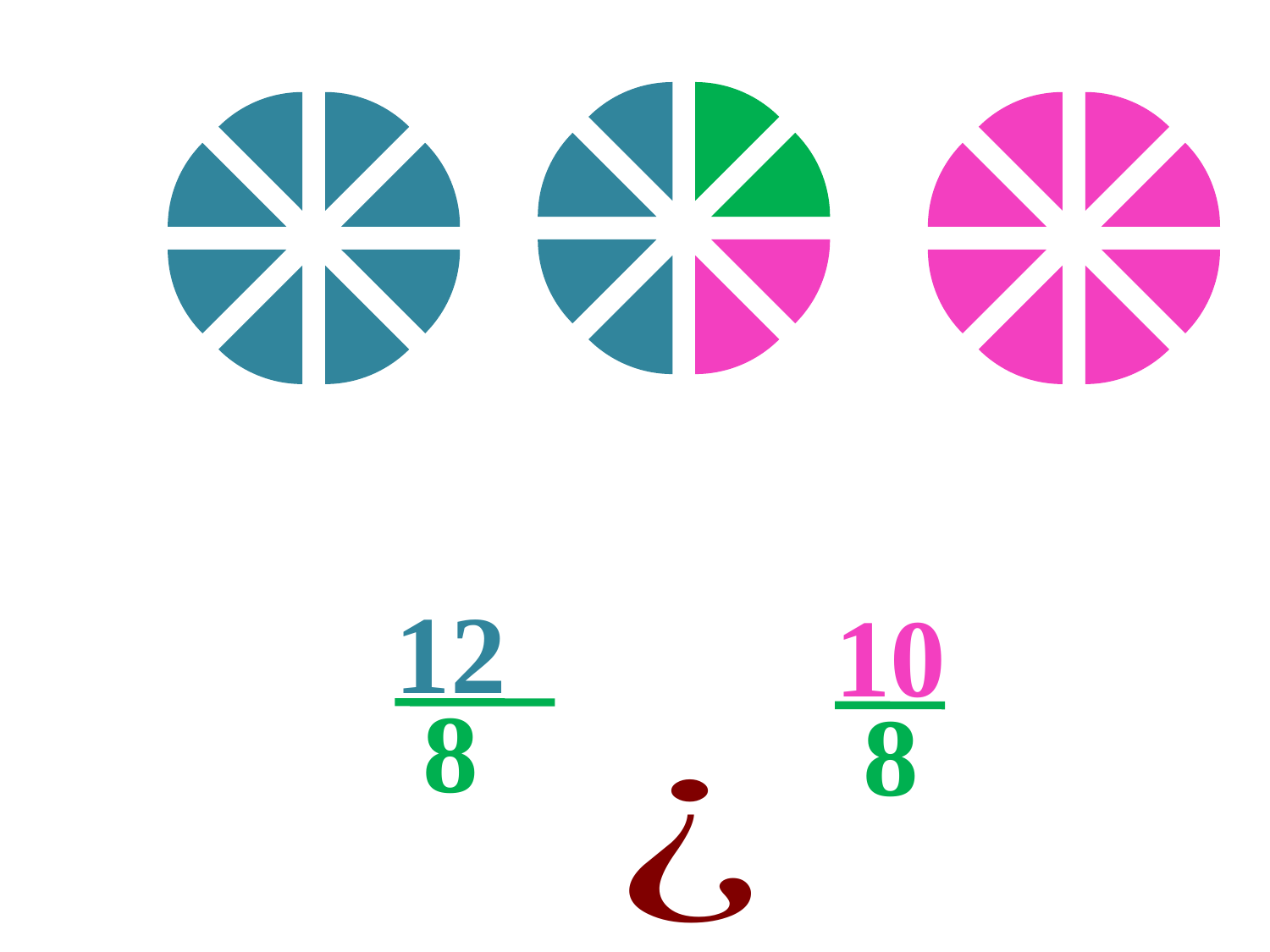
What fraction is printed on the left below the circles? 12/8 How many equal slices is the left circle divided into? 8 In the middle circle, how many slices are green? 2 In the middle circle, how many slices are pink? 2 What colour are all the slices of the right circle? pink What share of the middle circle is green? 2/8 In the middle circle, which colour covers more slices, teal or green? teal What kind of chart are the three circular figures? pie chart How many pink slices are there in total across all three circles? 10 How many teal slices are there in total across all three circles? 12